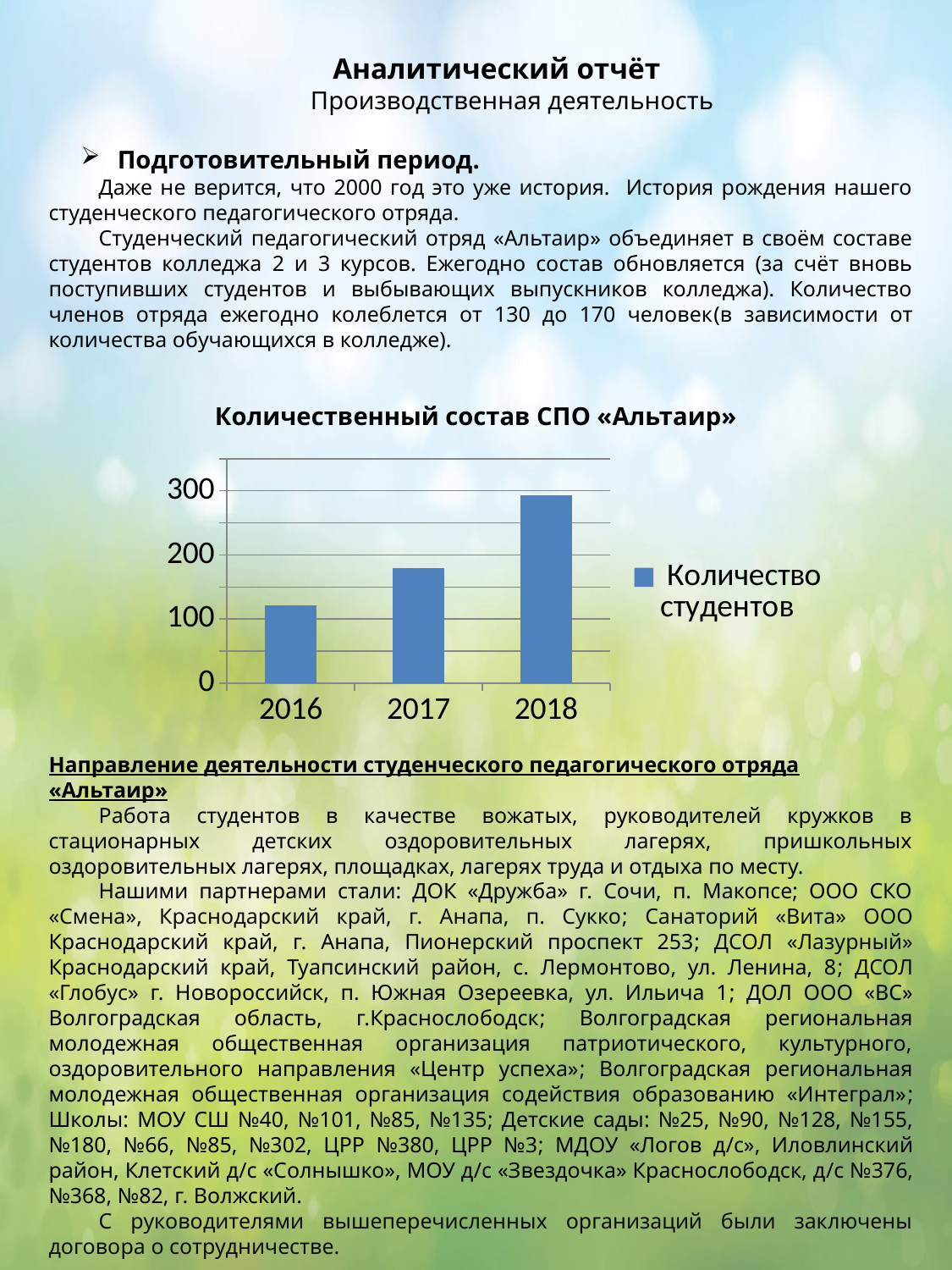
How many series does the chart legend list? 1 Do the values in the chart rise or fall from 2016 to 2018? rise Which year has a larger value, 2016 or 2017? 2017 Which year has the highest number of students in the chart? 2018 Is the value for 2016 greater or less than 100? greater What is the title of the chart? Количественный состав СПО «Альтаир» What kind of chart is shown on the slide? bar chart Is the value for 2017 greater or less than 200? less Which year has the lowest number of students in the chart? 2016 What is the name of the series shown in the legend? Количество студентов Is the value for 2018 greater or less than 200? greater How many years (categories) are shown on the x axis of the chart? 3